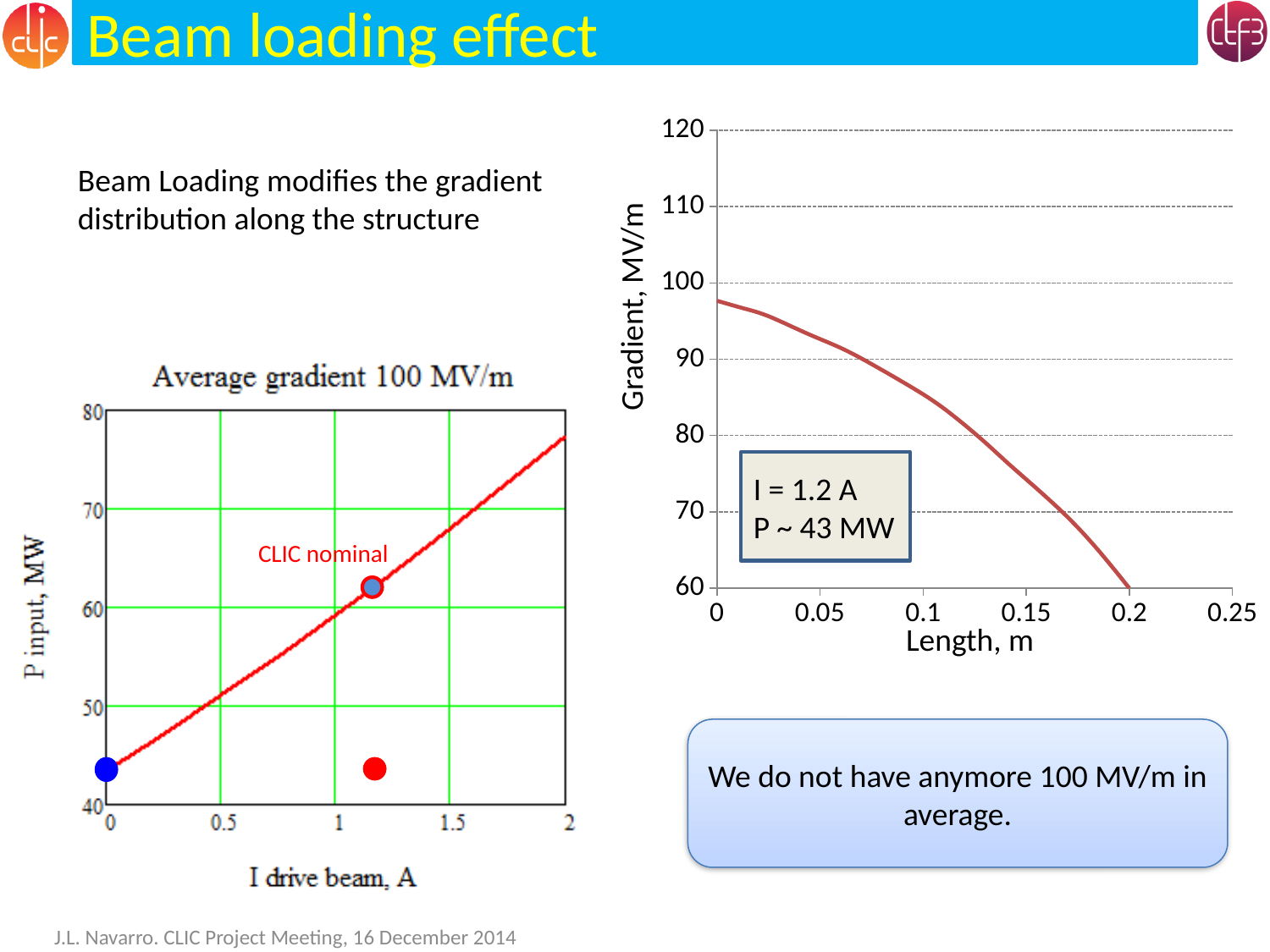
What is the x axis label of the left chart titled "Average gradient 100 MV/m"? I drive beam, A In the right chart with the y axis "Gradient, MV/m", does the gradient rise or fall as length increases? fall In the left chart titled "Average gradient 100 MV/m", is the P input at I drive beam = 0 A greater or less than 50 MW? less How many charts are on the slide? 2 In the right chart with the y axis "Gradient, MV/m", is the gradient at length 0 m greater or less than 90 MV/m? greater In the left chart titled "Average gradient 100 MV/m", is the P input at I drive beam = 2 A greater or less than 70 MW? greater What current and power are stated in the annotation box on the right chart with the y axis "Gradient, MV/m"? I = 1.2 A, P ~ 43 MW What kind of chart is the left chart titled "Average gradient 100 MV/m"? line chart What kind of chart is the right chart with the y axis "Gradient, MV/m"? line chart In the left chart titled "Average gradient 100 MV/m", does P input rise or fall as I drive beam increases? rise